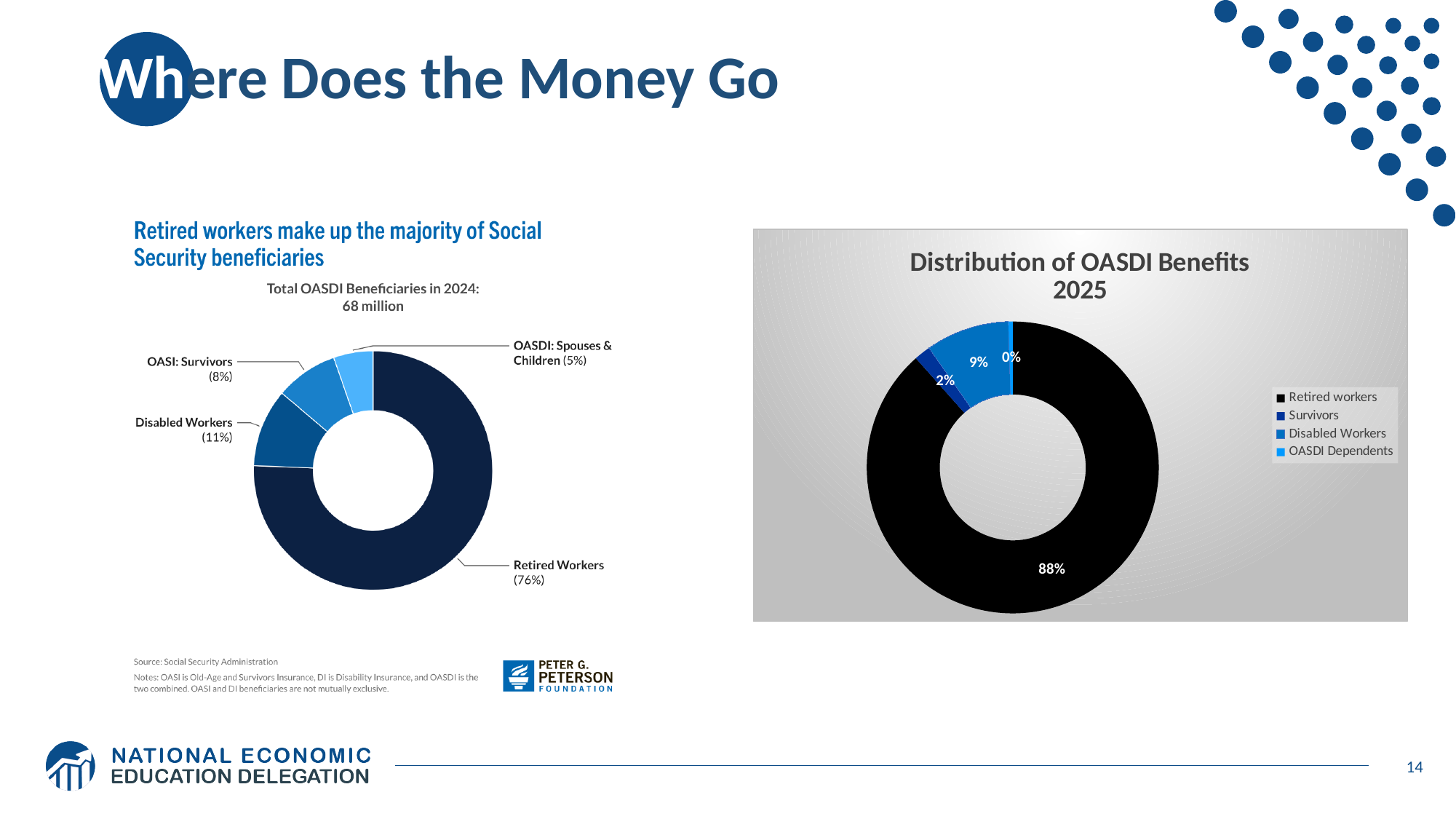
According to the left chart's title, how many total OASDI beneficiaries were there in 2024? 68 million In the 'Total OASDI Beneficiaries in 2024' chart on the left, what is the difference in percentage points between OASI: Survivors and OASDI: Spouses & Children? 3 percentage points In the 'Total OASDI Beneficiaries in 2024' chart on the left, what percentage are Disabled Workers? 11% In the 'Total OASDI Beneficiaries in 2024' chart on the left, which category has the smallest share? OASDI: Spouses & Children In the 'Distribution of OASDI Benefits 2025' chart, what share of benefits goes to Disabled Workers? 9% In the 'Distribution of OASDI Benefits 2025' chart, what share of benefits goes to Survivors? 2% In the 'Distribution of OASDI Benefits 2025' chart, which category has the largest share? Retired workers In the 'Distribution of OASDI Benefits 2025' chart, what share of benefits goes to Retired workers? 88% In the 'Distribution of OASDI Benefits 2025' chart, what share is shown for OASDI Dependents? 0% How many entries does the legend of the 'Distribution of OASDI Benefits 2025' chart list? 4 What kind of chart is the 'Distribution of OASDI Benefits 2025' chart? Donut (pie) chart In the 'Total OASDI Beneficiaries in 2024' chart on the left, what percentage are Retired Workers? 76%